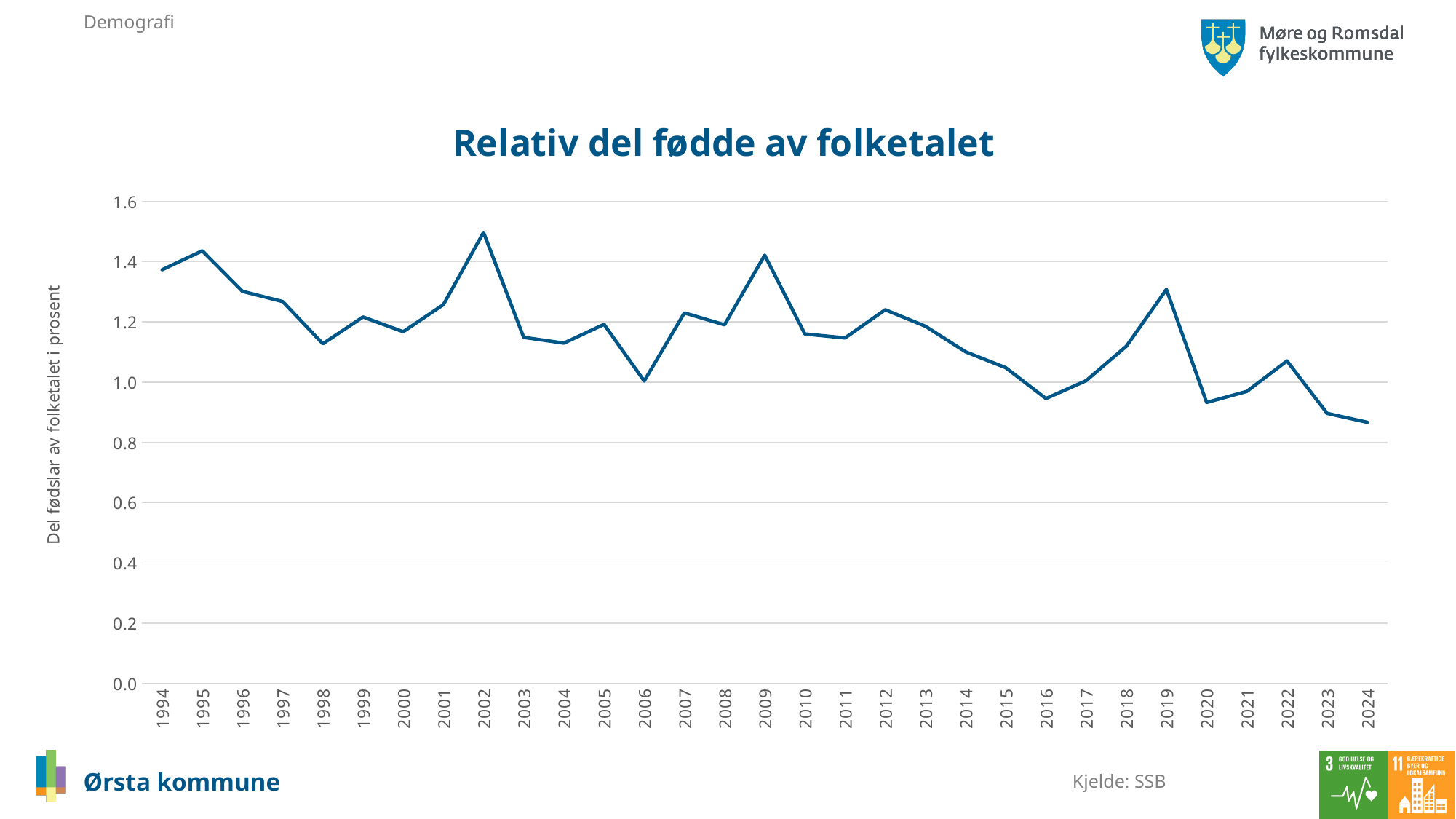
What is the label on the vertical axis of the chart? Del fødslar av folketalet i prosent What is the title of the chart? Relativ del fødde av folketalet How many years are plotted along the x axis of the chart? 31 Is the value for 1994 greater or less than 1.2? greater Overall, do the values rise or fall from 1994 to 2024? fall Is the value for 2002 greater or less than 1.4? greater Is the value for 2024 greater or less than 1.0? less Which year has the highest value in the chart? 2002 Which year has the larger value, 1995 or 2016? 1995 What kind of chart is shown on the slide? line chart